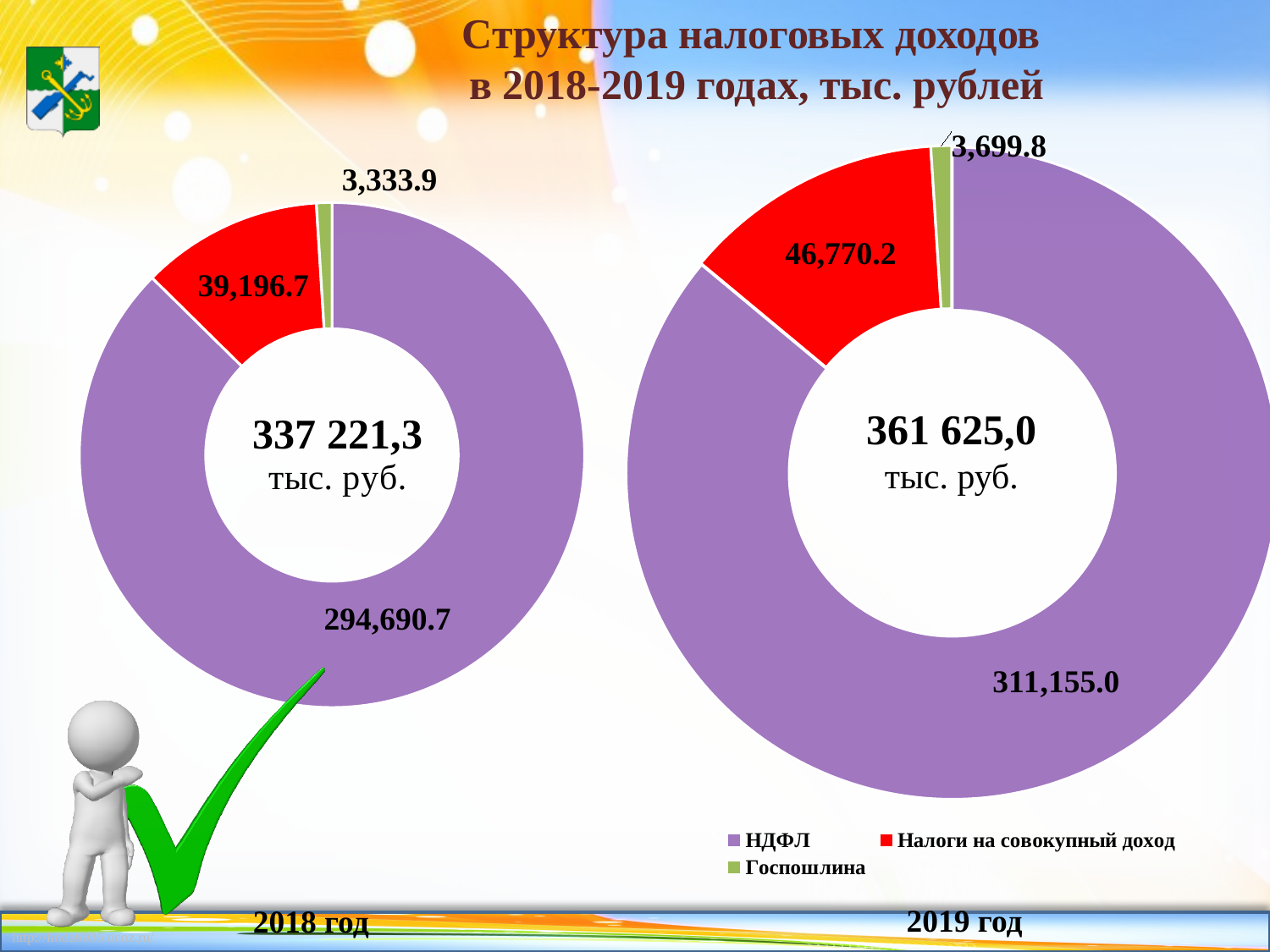
Which is larger: Госпошлина in the 2018 год chart or Госпошлина in the 2019 год chart? 2019 год In the 2019 год chart, what is the value for Налоги на совокупный доход? 46,770.2 In the 2018 год chart, which category has the largest slice? НДФЛ In the 2019 год chart, which category has the smallest slice? Госпошлина What total is shown in the centre of the 2019 год chart? 361 625,0 тыс. руб. How many series does the legend list? 3 In the 2018 год chart, what is the value for НДФЛ? 294,690.7 What is the difference between Налоги на совокупный доход in the 2019 год chart and in the 2018 год chart? 7,573.5 In the 2019 год chart, what is the value for Госпошлина? 3,699.8 What kind of chart is used on this slide? Doughnut (pie) chart In the 2018 год chart, what is the value for Госпошлина? 3,333.9 What is the difference between the НДФЛ value in the 2019 год chart and the НДФЛ value in the 2018 год chart? 16,464.3